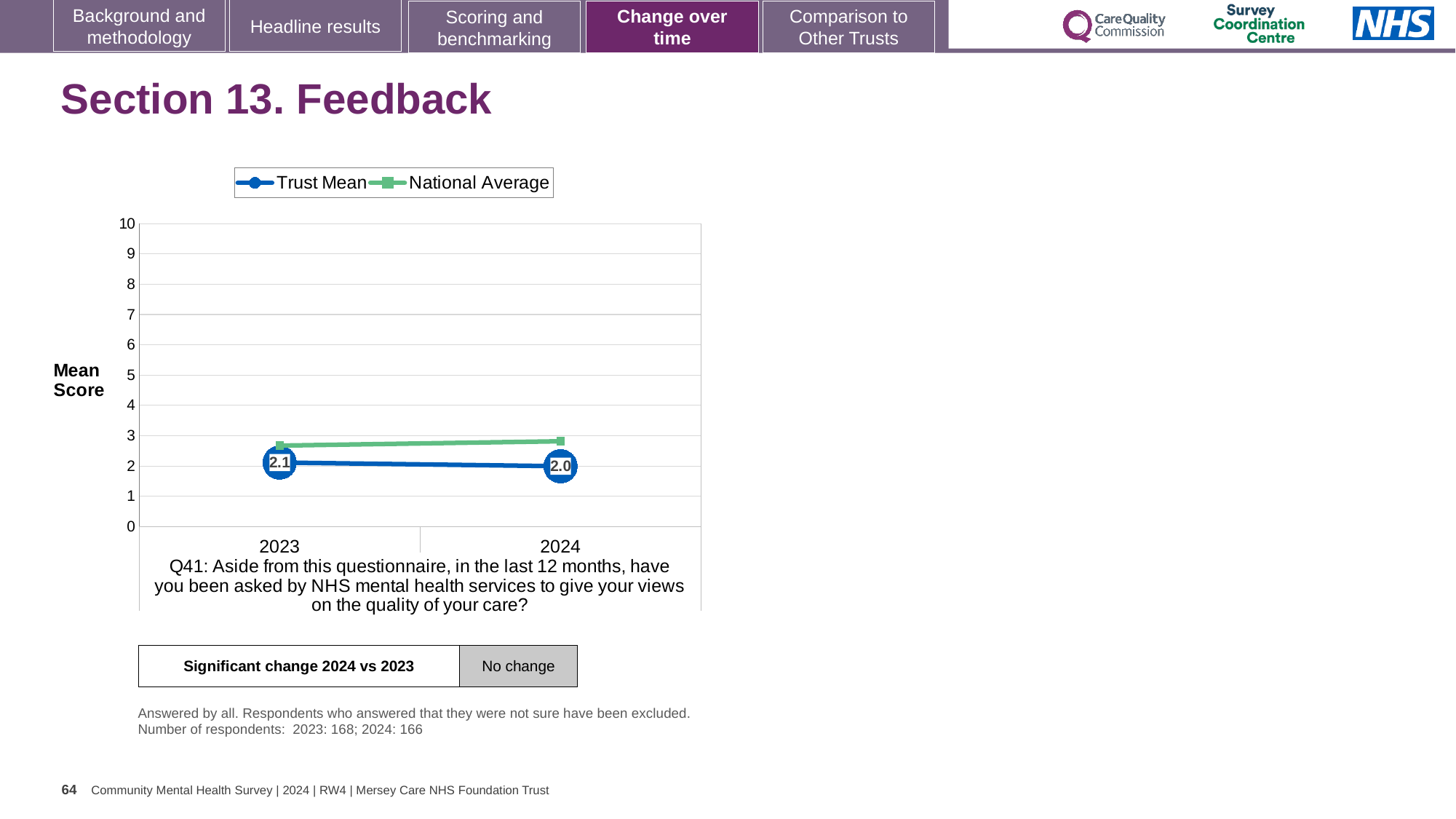
In 2024, which is higher, the Trust Mean or the National Average? National Average How many series does the legend list? 2 What is the Trust Mean value for 2023? 2.1 Does the Trust Mean rise or fall from 2023 to 2024? Fall Is the National Average value for 2024 greater or less than 5? less What is the Trust Mean value for 2024? 2.0 Which year has the higher Trust Mean, 2023 or 2024? 2023 Is the National Average value for 2023 greater or less than 2? greater What is the difference between the Trust Mean in 2023 and in 2024? 0.1 What kind of chart is shown on the slide? Line chart What is the label on the y axis of the chart? Mean Score How many years are plotted on the x axis? 2